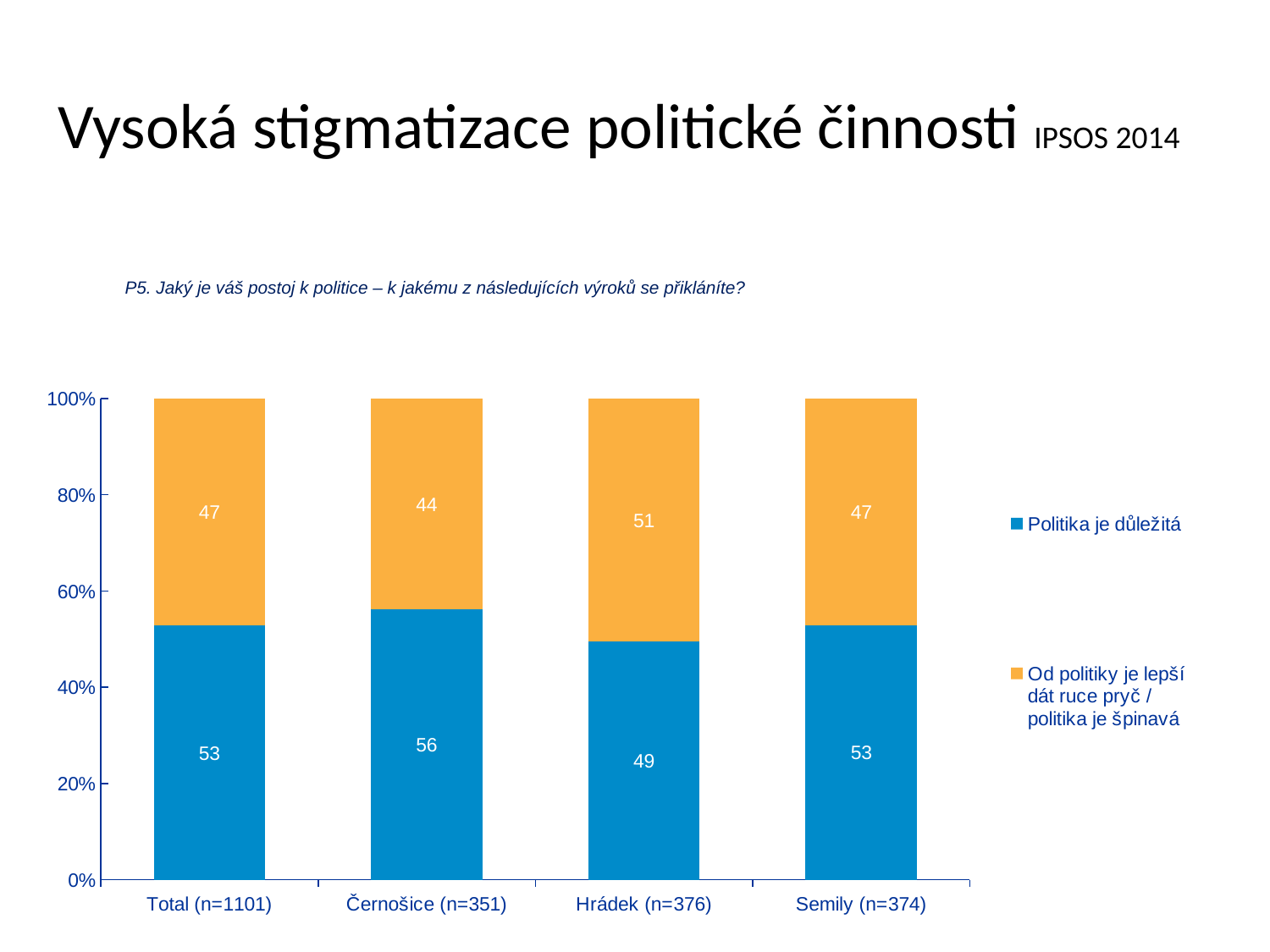
Which category has the lowest value for "Politika je důležitá"? Hrádek (n=376) What is the difference between the "Politika je důležitá" values for Černošice (n=351) and Hrádek (n=376)? 7 How many series does the legend list? 2 What is the value for "Politika je důležitá" in Černošice (n=351)? 56 What is the value for "Politika je důležitá" in Total (n=1101)? 53 Which category has the highest value for "Politika je důležitá"? Černošice (n=351) Which colour represents "Politika je důležitá" in the chart? Blue What kind of chart is shown on the slide? Stacked bar chart What is the total of the stacked bar for Hrádek (n=376)? 100 What is the value for "Od politiky je lepší dát ruce pryč / politika je špinavá" in Hrádek (n=376)? 51 Which is larger in Semily (n=374): "Politika je důležitá" or "Od politiky je lepší dát ruce pryč / politika je špinavá"? Politika je důležitá How many categories are shown on the x axis? 4